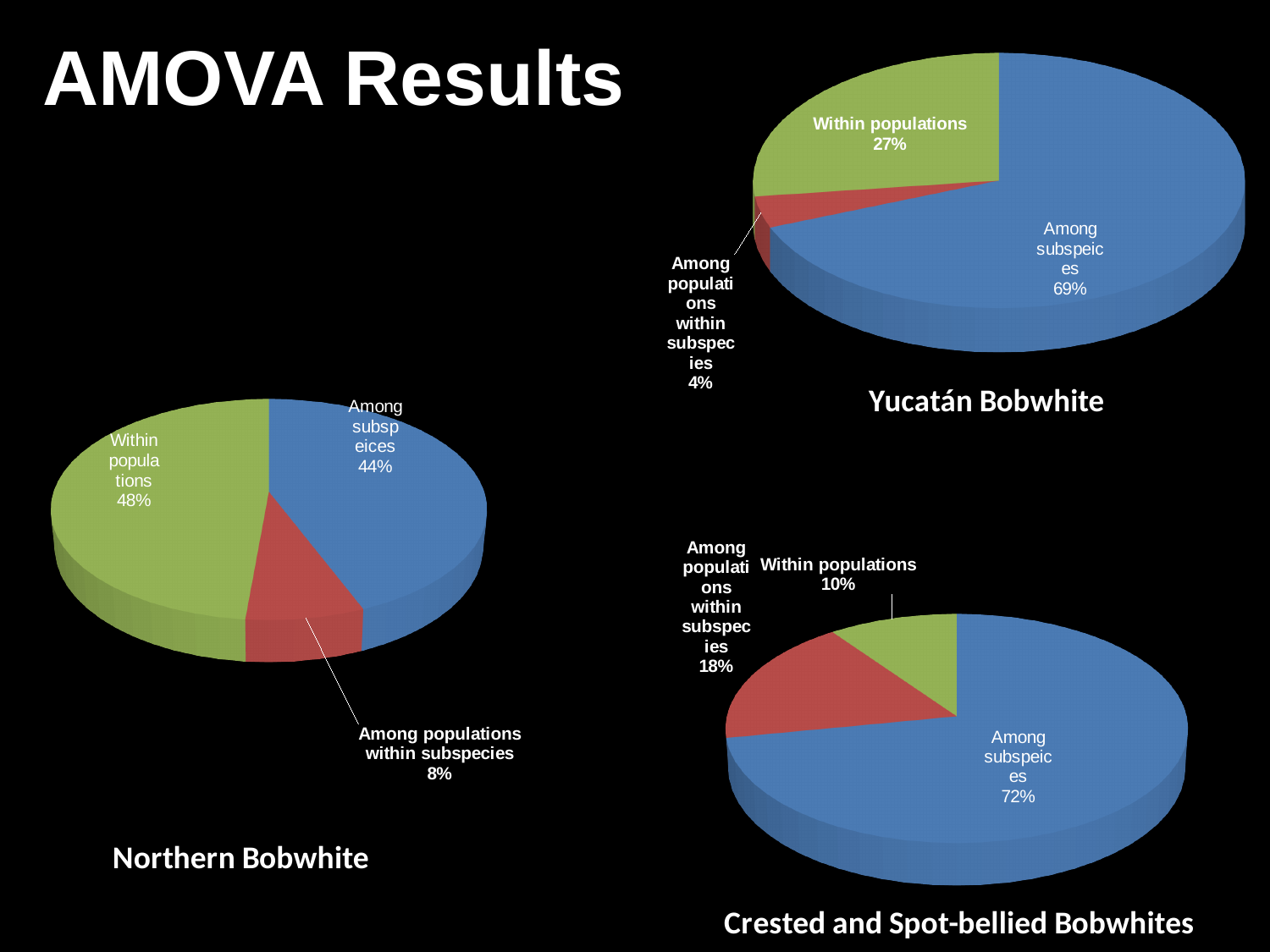
In the Northern Bobwhite chart, what share is labelled for Among populations within subspecies? 8% In the Crested and Spot-bellied Bobwhites chart, what share is labelled for Among populations within subspecies? 18% In the Yucatán Bobwhite chart, what share is labelled for Among subspecies? 69% In the Yucatán Bobwhite chart, which slice is the smallest? Among populations within subspecies In the Northern Bobwhite chart, what share is labelled for Within populations? 48% How many charts are shown on the slide? 3 What kind of chart is the Northern Bobwhite chart? Pie chart In the Yucatán Bobwhite chart, what share is labelled for Within populations? 27% How many slices does the Yucatán Bobwhite chart have? 3 In the Crested and Spot-bellied Bobwhites chart, which slice is the largest? Among subspecies In the Northern Bobwhite chart, what is the difference between the Within populations share and the Among subspecies share? 4% In the Crested and Spot-bellied Bobwhites chart, which is larger: Among populations within subspecies or Within populations? Among populations within subspecies